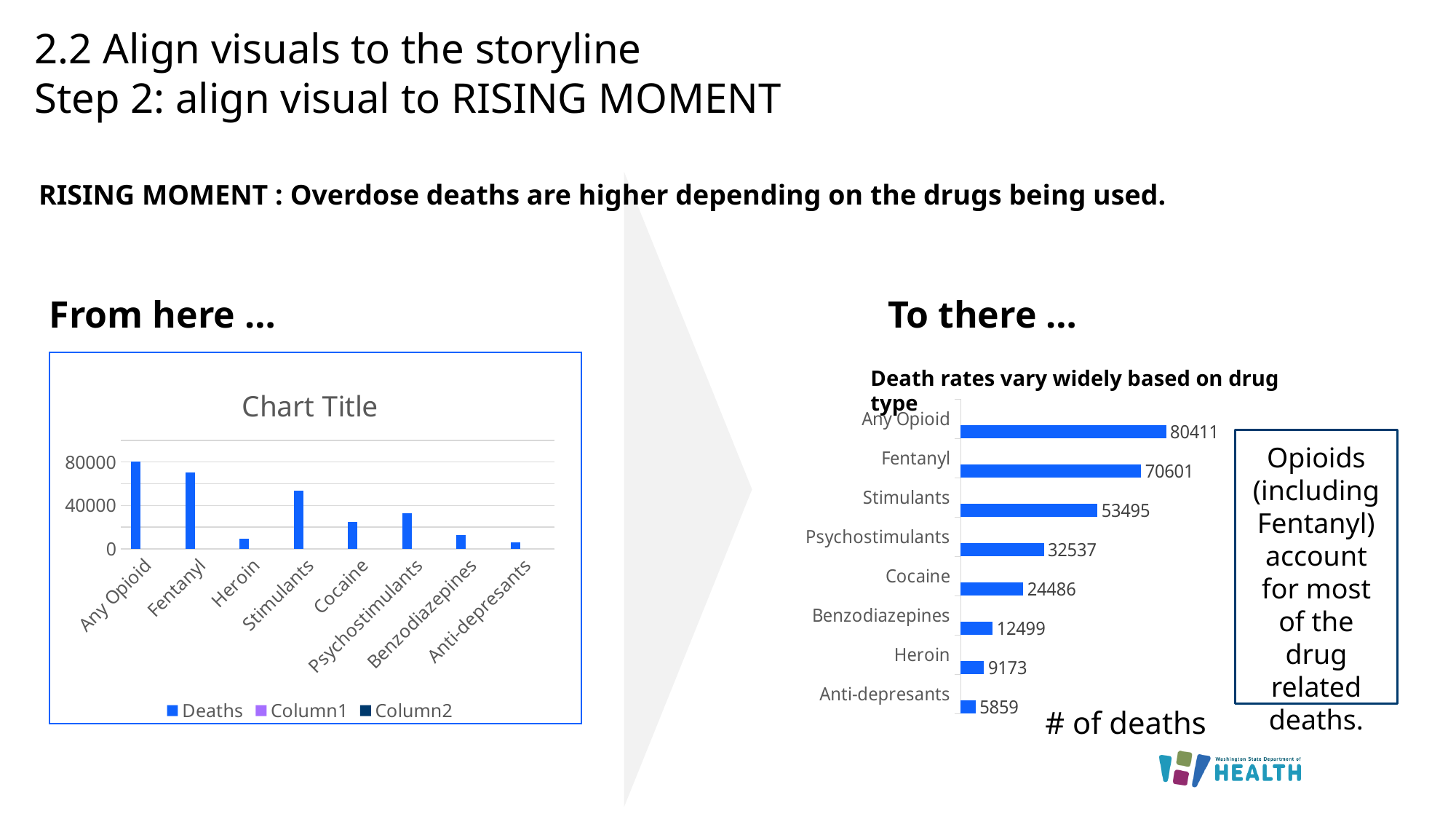
In the chart titled "Death rates vary widely based on drug type", which category has the lowest value? Anti-depresants In the chart titled "Death rates vary widely based on drug type", what is the value for Heroin? 9173 How many categories are shown in the chart titled "Death rates vary widely based on drug type"? 8 In the chart titled "Chart Title" on the left, is the value for Heroin greater or less than 40000? less In the chart titled "Death rates vary widely based on drug type", what is the difference between the values for Any Opioid and Fentanyl? 9810 In the chart titled "Death rates vary widely based on drug type", which category has the highest value? Any Opioid In the chart titled "Chart Title" on the left, is the value for Stimulants greater or less than 40000? greater In the chart titled "Death rates vary widely based on drug type", what is the value for Cocaine? 24486 What kind of chart is the chart titled "Chart Title" on the left of the slide? Bar chart How many series does the legend list in the chart titled "Chart Title" on the left? 3 In the chart titled "Death rates vary widely based on drug type", which is larger, the value for Stimulants or the value for Psychostimulants? Stimulants In the chart titled "Death rates vary widely based on drug type", what is the value for Fentanyl? 70601